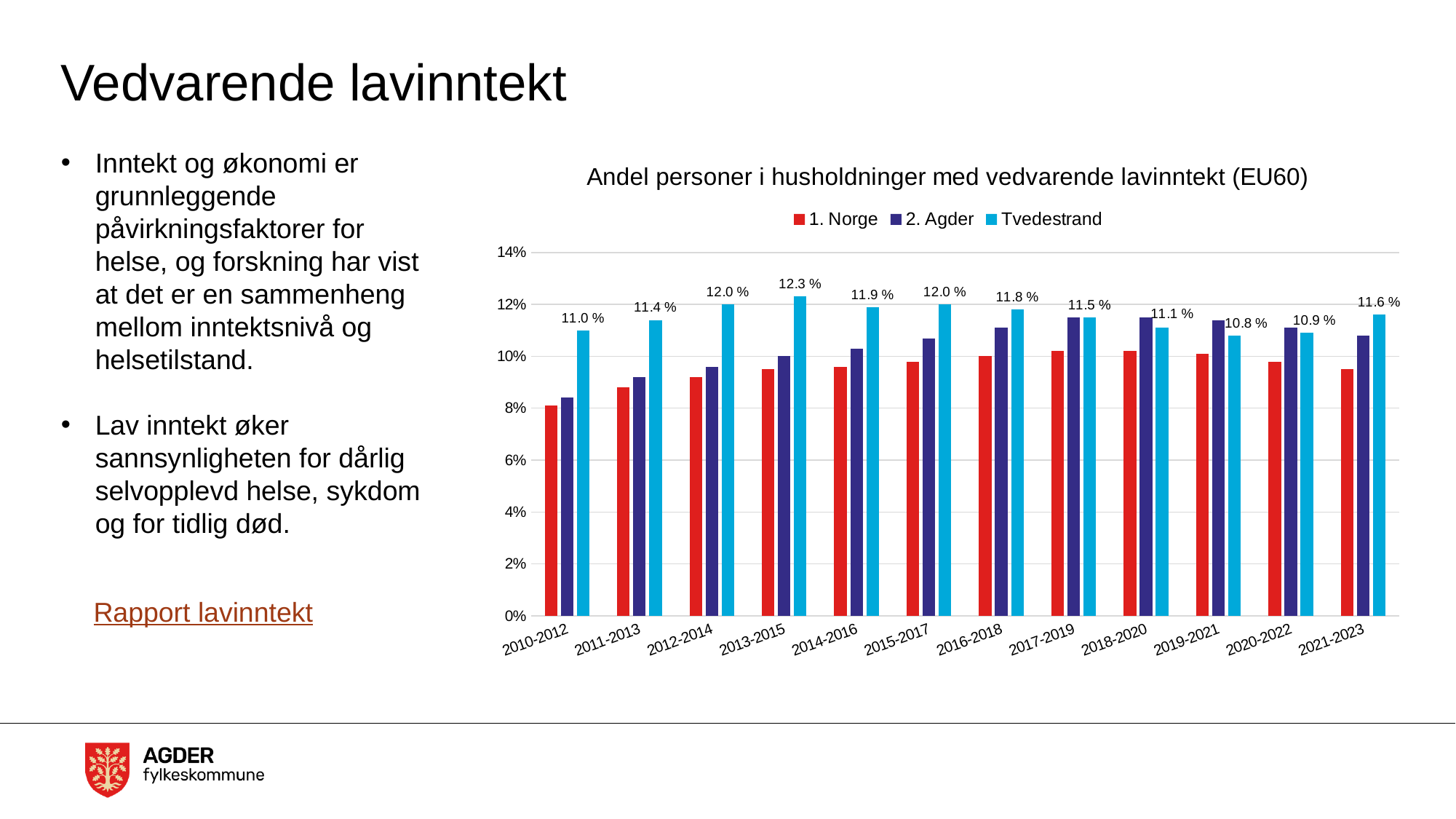
In which period is the Tvedestrand value lowest? 2019-2021 How many periods are shown on the x axis? 12 In which period is the Tvedestrand value highest? 2013-2015 What is the difference between the highest and lowest Tvedestrand values? 1.5 percentage points Which is larger for Tvedestrand: the value in 2011-2013 or the value in 2018-2020? 2011-2013 What is the title of the chart? Andel personer i husholdninger med vedvarende lavinntekt (EU60) What is the value for Tvedestrand in 2019-2021? 10.8 % What is the value for Tvedestrand in 2021-2023? 11.6 % Is the value for 1. Norge in 2010-2012 greater or less than 10%? less What kind of chart is shown on the slide? Bar chart How many series does the legend list? 3 What is the value for Tvedestrand in 2013-2015? 12.3 %